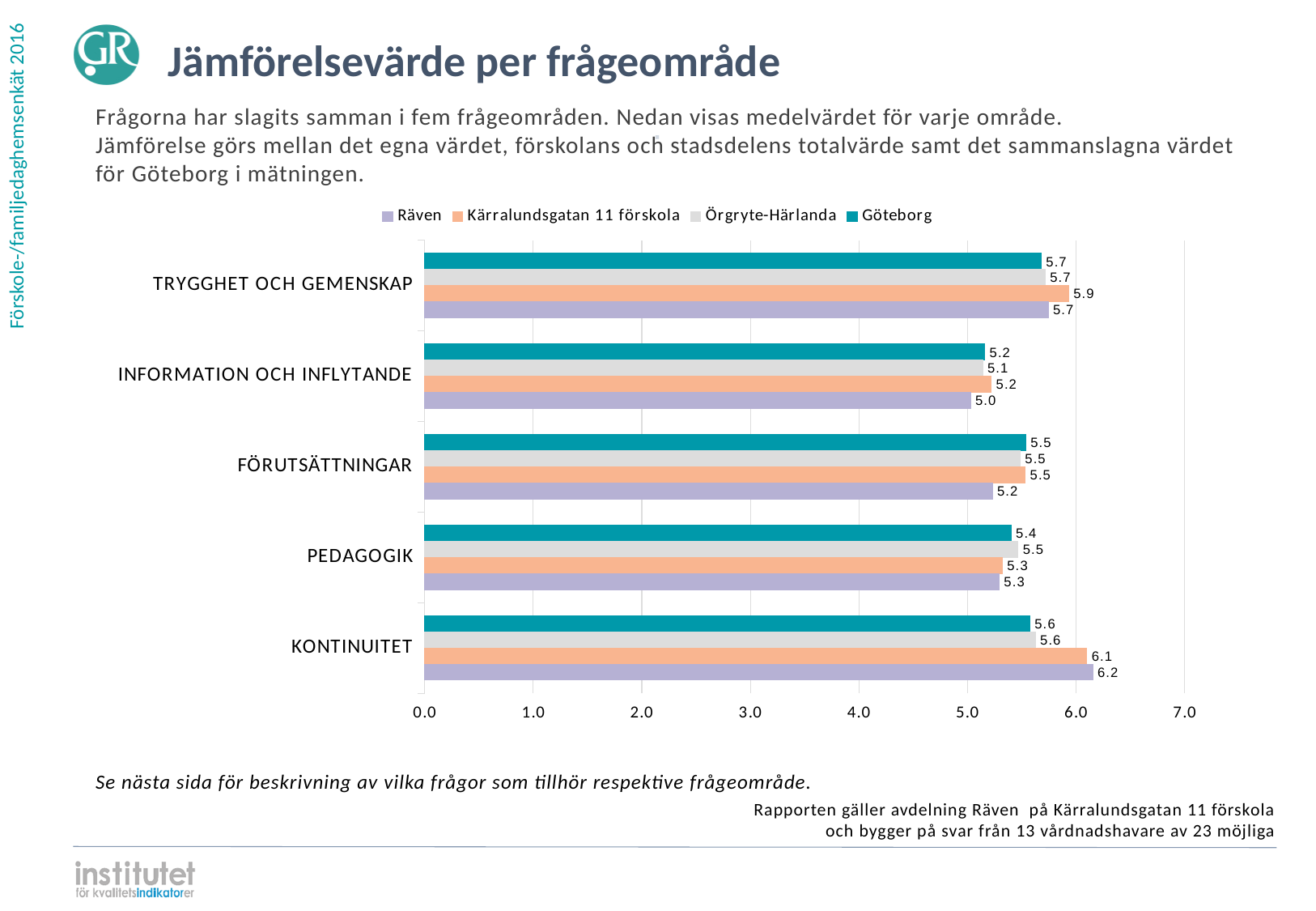
What is the value for Göteborg in PEDAGOGIK? 5.4 In which category does Räven have its highest value? KONTINUITET How many question areas (categories) are shown on the chart? 5 How many series does the legend list? 4 Which series is shown in orange in the legend? Kärralundsgatan 11 förskola What is the value for Räven in KONTINUITET? 6.2 Which is larger in FÖRUTSÄTTNINGAR: the value for Räven or the value for Göteborg? Göteborg In which category does Räven have its lowest value? INFORMATION OCH INFLYTANDE What is the value for Örgryte-Härlanda in INFORMATION OCH INFLYTANDE? 5.1 What is the difference between the Räven value and the Göteborg value in KONTINUITET? 0.6 What type of chart is shown on the slide? bar chart What is the value for Kärralundsgatan 11 förskola in TRYGGHET OCH GEMENSKAP? 5.9